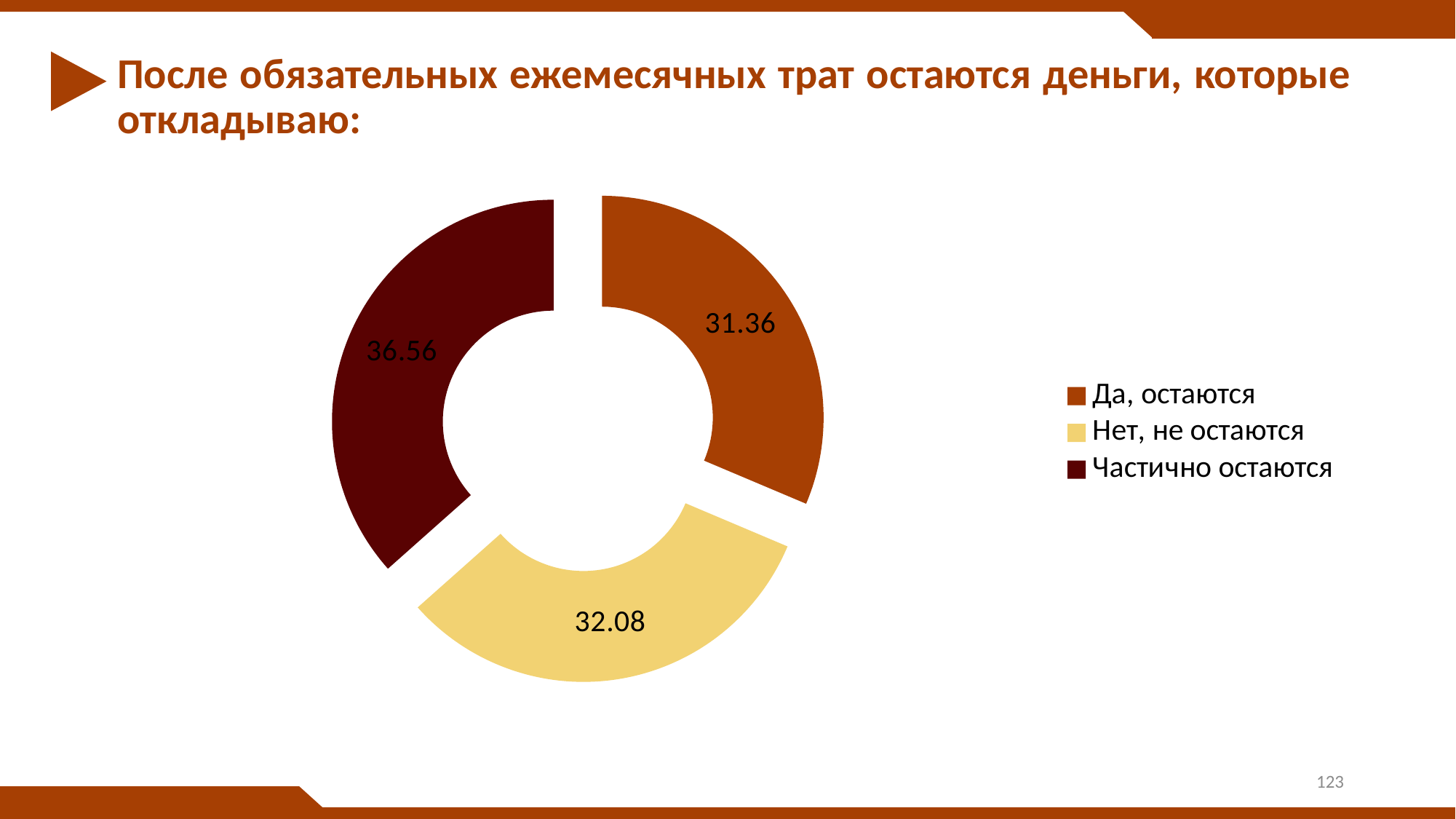
What value is shown for the "Нет, не остаются" slice? 32.08 Which colour represents the "Нет, не остаются" category? Yellow What value is shown for the "Да, остаются" slice? 31.36 What value is shown for the "Частично остаются" slice? 36.56 How many categories are shown in the chart? 3 How many entries does the legend list? 3 What is the difference between the values for "Частично остаются" and "Да, остаются"? 5.20 Which category has the smallest value in the chart? Да, остаются Which category has the largest value in the chart? Частично остаются Which is larger: the value for "Нет, не остаются" or the value for "Да, остаются"? Нет, не остаются What is the difference between the values for "Частично остаются" and "Нет, не остаются"? 4.48 What kind of chart is shown on the slide? Doughnut (pie) chart